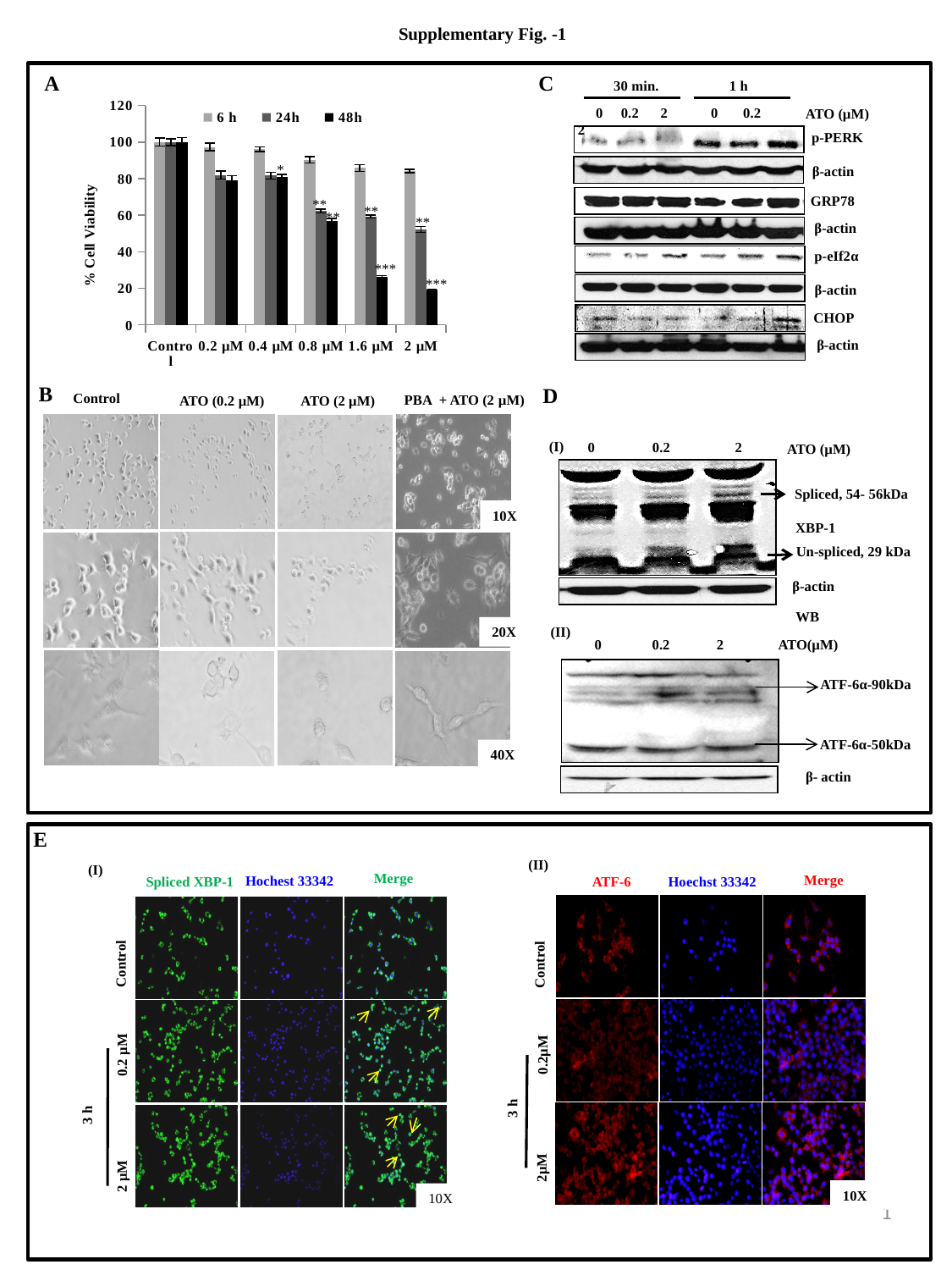
In panel A, is the 48h value at 2 µM greater or less than 40? less In panel A, which concentration has the lowest 48h cell viability? 2 µM In panel A, which series has the highest value at 2 µM? 6 h In panel A, is the 48h value at 1.6 µM greater or less than 40? less In panel A, is the 24h value at 0.8 µM greater or less than 80? less In panel A, how many series does the legend list? 3 In panel A, what is the label on the y axis? % Cell Viability In panel A, does the 48h series rise or fall as the ATO concentration increases along the x axis? fall What kind of chart is panel A? bar chart In panel A, how many concentration categories are shown on the x axis? 6 In panel A, at 1.6 µM, which is larger: the 24h value or the 48h value? 24h